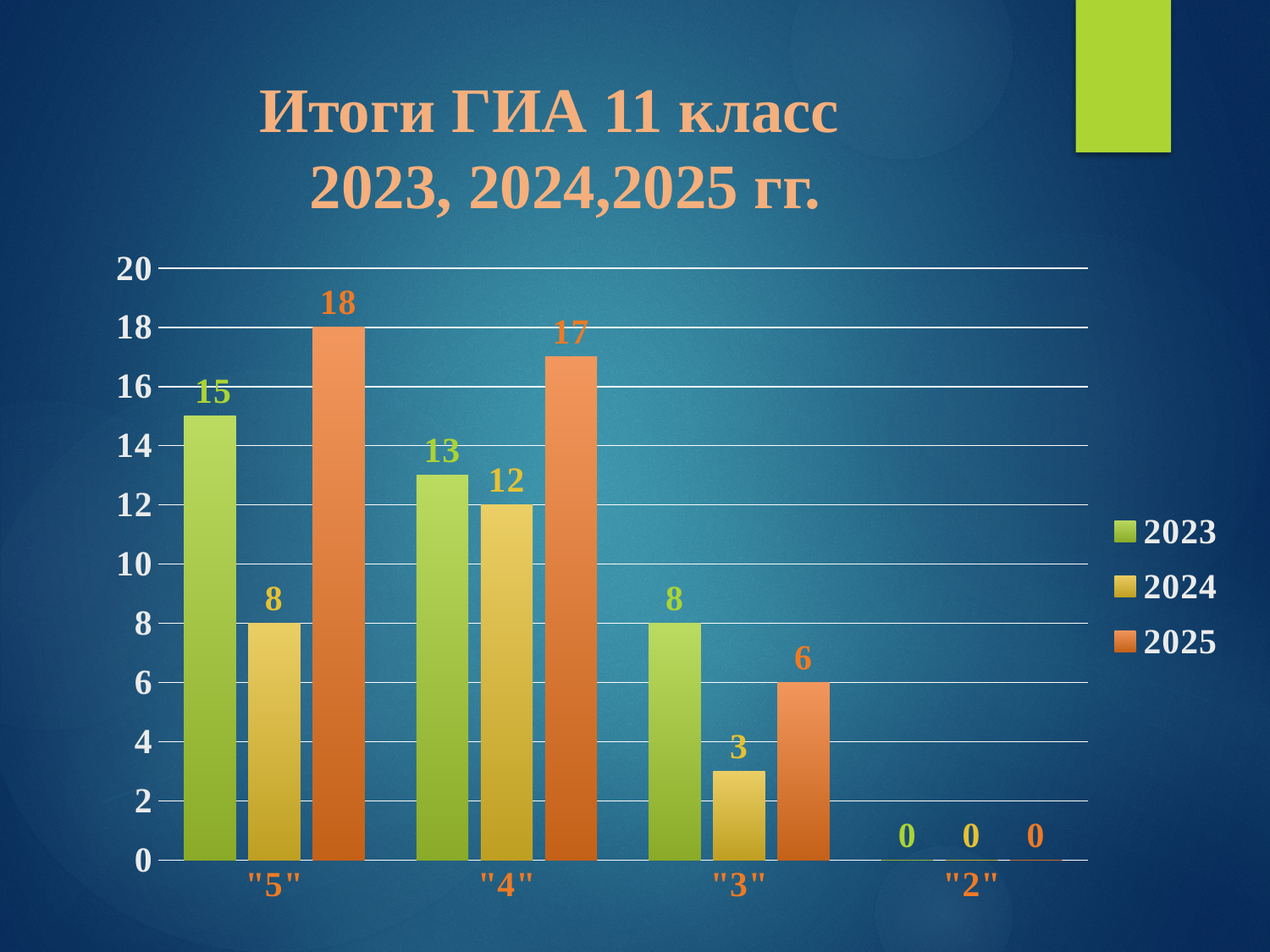
What is the difference between the 2025 and 2024 values for "5"? 10 What kind of chart is shown on the slide? bar chart Do the values in the 2023 series rise or fall from "5" to "2" along the x axis? fall Which category has the highest value in the 2024 series? "4" How many series does the legend list? 3 What is the title of the chart? Итоги ГИА 11 класс 2023, 2024,2025 гг. What is the value for "3" in the 2023 series? 8 Which is larger for "3": the 2025 value or the 2024 value? 2025 Which category has the lowest value in the 2025 series? "2" What is the value for "5" in the 2025 series? 18 What is the value for "4" in the 2024 series? 12 How many categories are shown on the x axis? 4